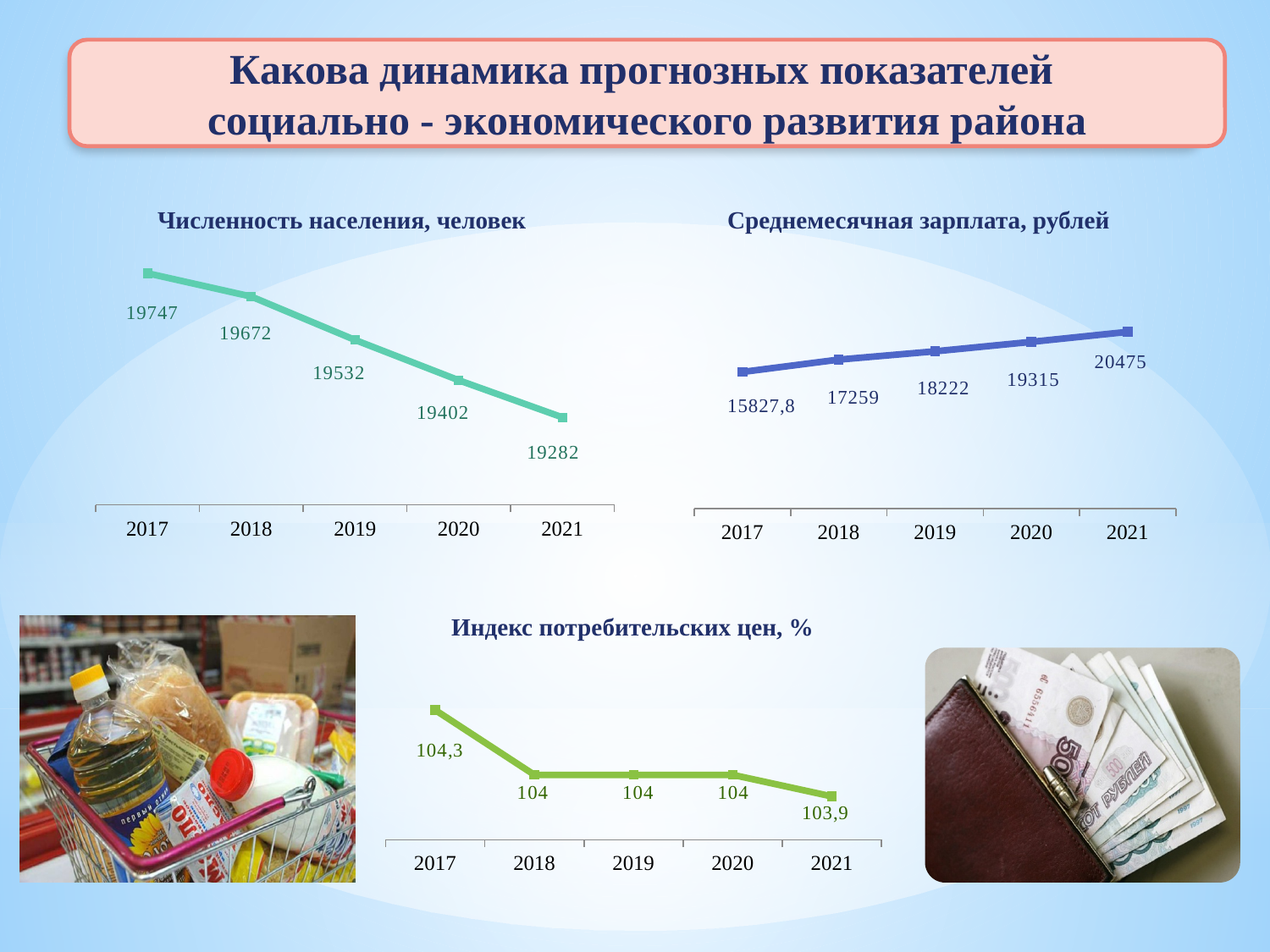
In the chart 'Численность населения, человек', do the values rise or fall from 2017 to 2021? fall How many charts are shown on the slide? 3 In the chart 'Среднемесячная зарплата, рублей', which year has the highest value? 2021 In the chart 'Численность населения, человек', what is the difference between the 2017 and 2021 values? 465 In the chart 'Численность населения, человек', what is the value for 2019? 19532 In the chart 'Среднемесячная зарплата, рублей', what is the value for 2017? 15827,8 In the chart 'Среднемесячная зарплата, рублей', what is the difference between the 2021 and 2020 values? 1160 In the chart 'Индекс потребительских цен, %', what is the value for 2021? 103,9 In the chart 'Индекс потребительских цен, %', which is larger, the value for 2017 or the value for 2018? 2017 What kind of chart is 'Индекс потребительских цен, %'? line chart In the chart 'Среднемесячная зарплата, рублей', how many years are plotted? 5 In the chart 'Численность населения, человек', which year has the lowest value? 2021